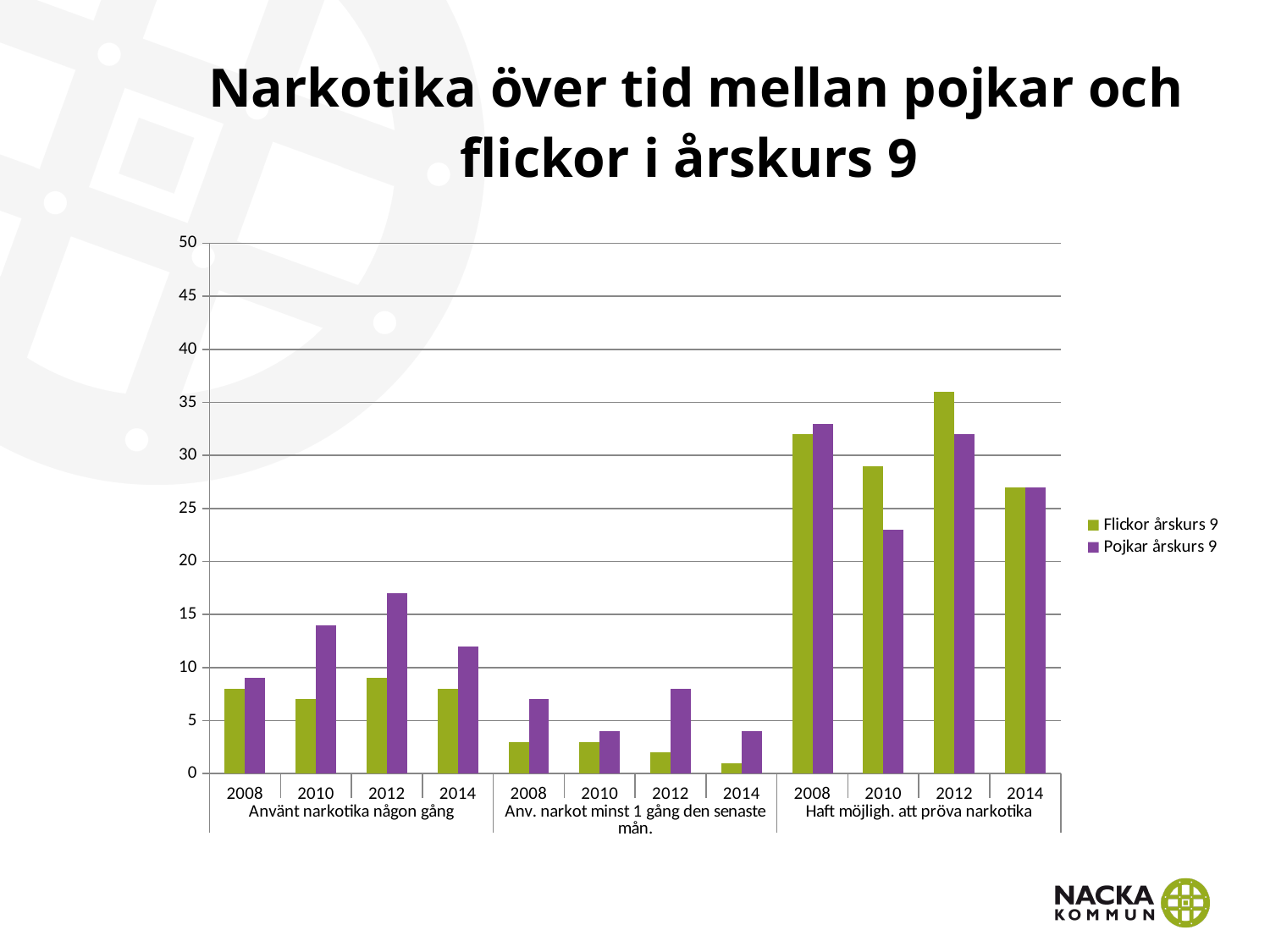
How many series does the legend list? 2 Is the value for Pojkar årskurs 9 in 2012 under 'Använt narkotika någon gång' greater or less than 15? greater Is the value for Flickor årskurs 9 in 2012 under 'Haft möjligh. att pröva narkotika' greater or less than 30? greater Which series and category has the lowest bar in the chart? Flickor årskurs 9, 2014, Anv. narkot minst 1 gång den senaste mån. Which series and category has the highest bar in the chart? Flickor årskurs 9, 2012, Haft möjligh. att pröva narkotika What kind of chart is shown on the slide? Bar chart Which colour represents Pojkar årskurs 9 in the chart? Purple In 2010 under 'Haft möjligh. att pröva narkotika', which series has the larger value, Flickor årskurs 9 or Pojkar årskurs 9? Flickor årskurs 9 How many bar groups (year categories) are plotted along the x axis? 12 In 2010 under 'Använt narkotika någon gång', which series has the larger value, Flickor årskurs 9 or Pojkar årskurs 9? Pojkar årskurs 9 Is the value for Pojkar årskurs 9 in 2010 under 'Haft möjligh. att pröva narkotika' greater or less than 25? less